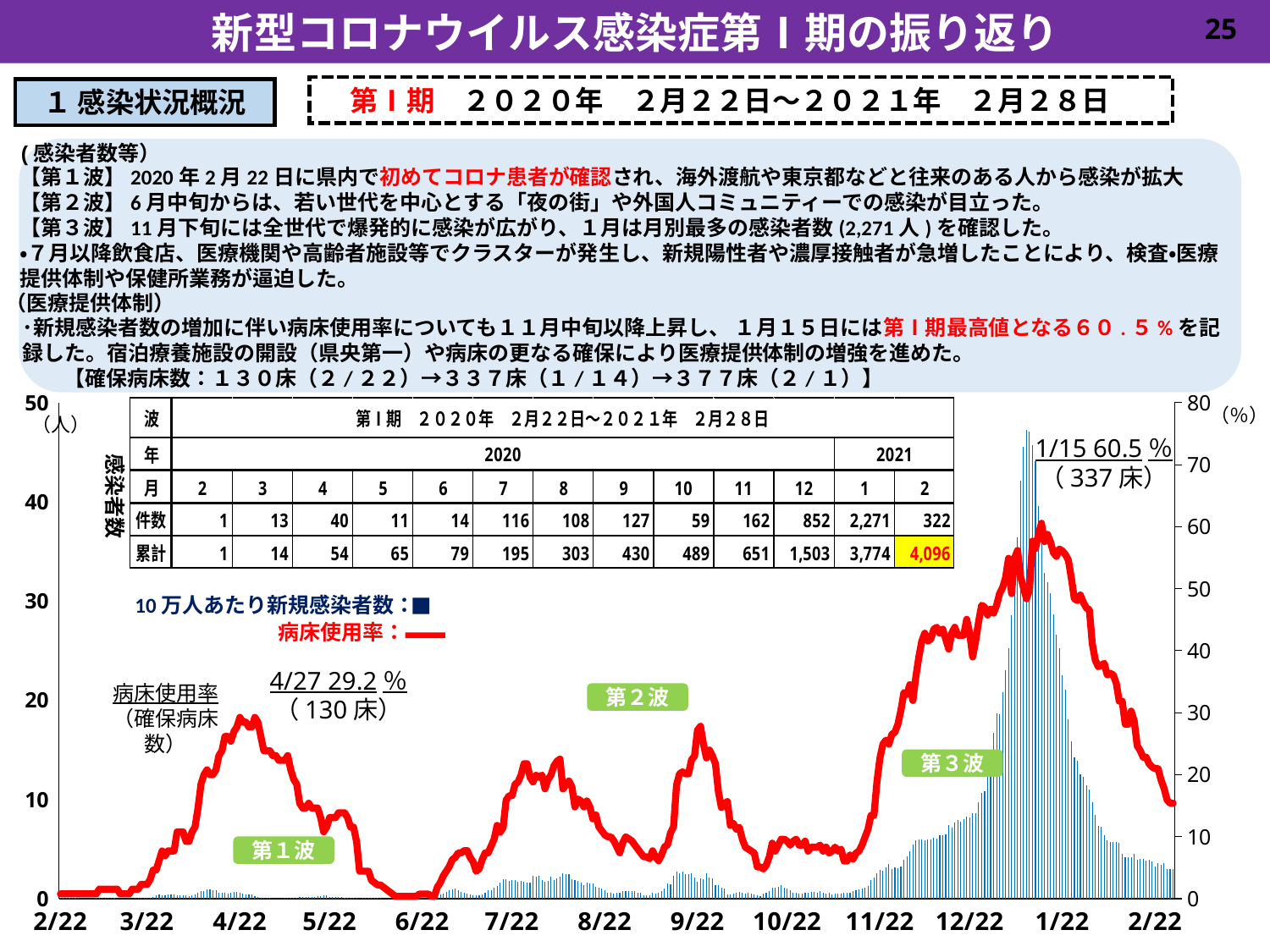
How many secured beds (確保病床数) are shown in the label for 1/15? 337床 In the table on the chart, which month had the highest number of cases (件数)? 1 (January 2021) What kind of chart is shown on the slide? Combined bar and line chart How many series does the chart legend list? 2 Is the bed occupancy rate at the start of the chart on 2/22 greater or less than 10%? less What is the maximum value shown on the right-hand (%) axis of the chart? 80 Is the bed occupancy rate at the peak near 9/22 greater or less than 20%? greater In the table on the chart, what is the cumulative total (累計) for February 2021? 4,096 Which date had the higher labelled bed occupancy rate, 4/27 or 1/15? 1/15 What was the bed occupancy rate (病床使用率) on 4/27 according to the data label on the chart? 29.2% What is the difference in percentage points between the bed occupancy rate on 1/15 and on 4/27? 31.3 What was the bed occupancy rate (病床使用率) on 1/15 according to the data label on the chart? 60.5%